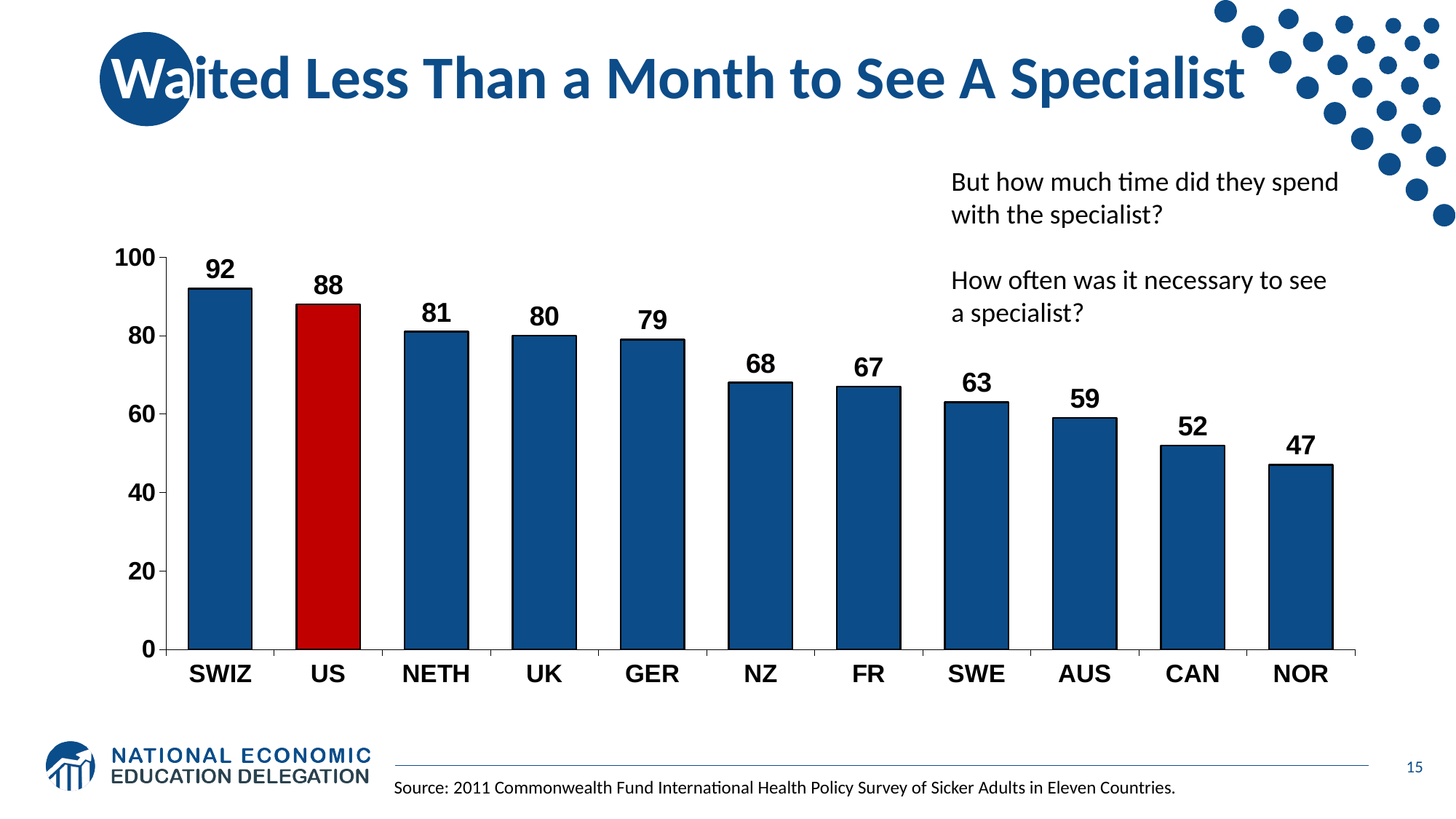
What is the difference between the values for US and NETH? 7 Which country has the highest value? SWIZ What kind of chart is shown on the slide? bar chart What is the value for CAN? 52 How many countries are shown on the chart? 11 What is the difference between the values for SWIZ and NOR? 45 Which is larger, the value for NZ or the value for SWE? NZ Is the value for AUS greater or less than 60? less What is the value for GER? 79 Which country has the lowest value? NOR What is the value for the US? 88 Which bar is coloured red rather than blue? US